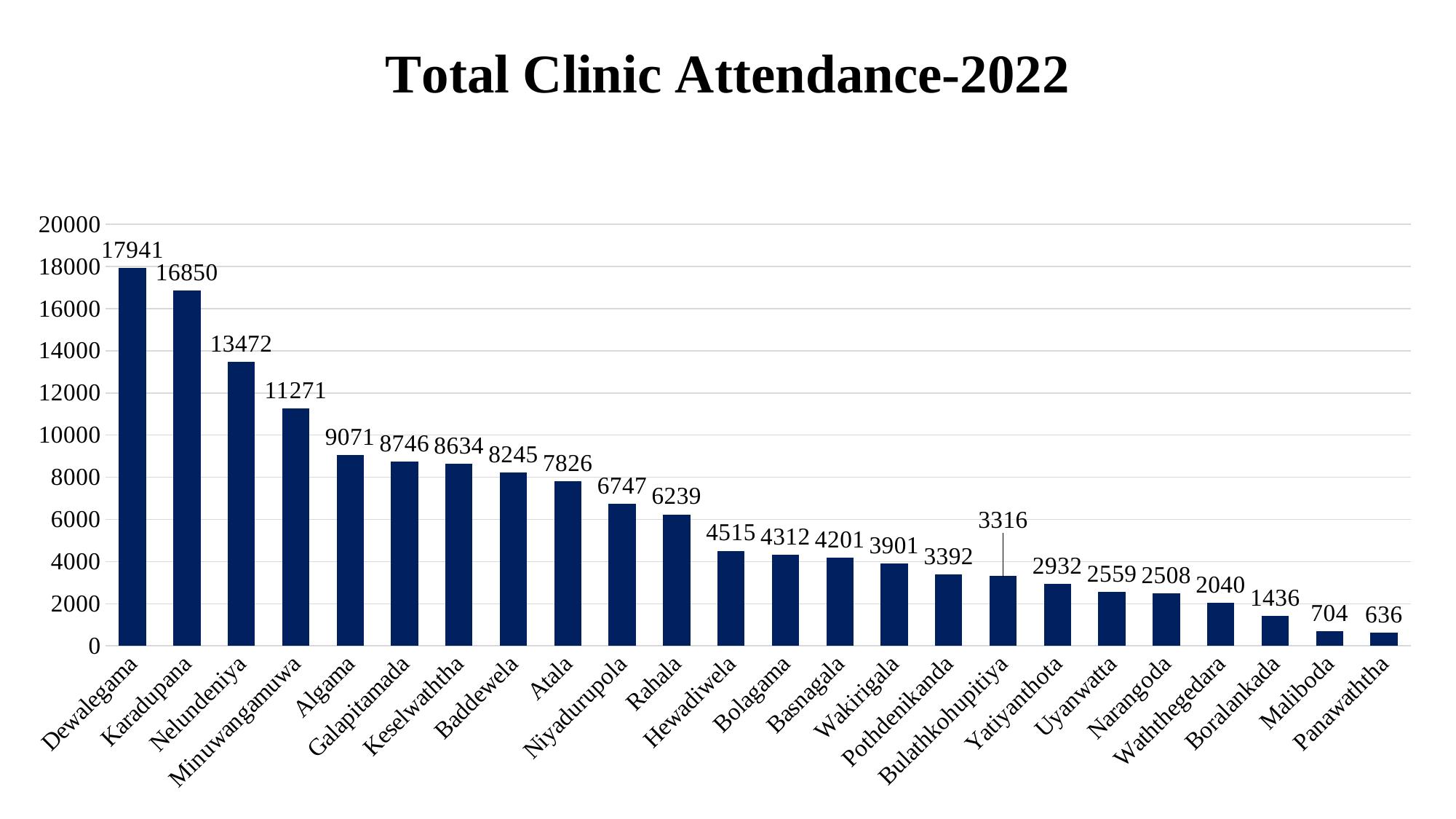
What is the title of the chart? Total Clinic Attendance-2022 What kind of chart is shown on the slide? Bar chart Which clinic has the lowest total attendance? Panawaththa What is the total clinic attendance for Rahala? 6239 What is the total clinic attendance for Nelundeniya? 13472 Which has higher attendance, Hewadiwela or Wakirigala? Hewadiwela Is the attendance for Minuwangamuwa greater or less than 10000? greater What is the total clinic attendance for Bulathkohupitiya? 3316 What is the difference in attendance between Algama and Galapitamada? 325 What is the difference in attendance between Dewalegama and Karadupana? 1091 How many clinics are shown on the chart? 24 Which clinic has the highest total attendance? Dewalegama